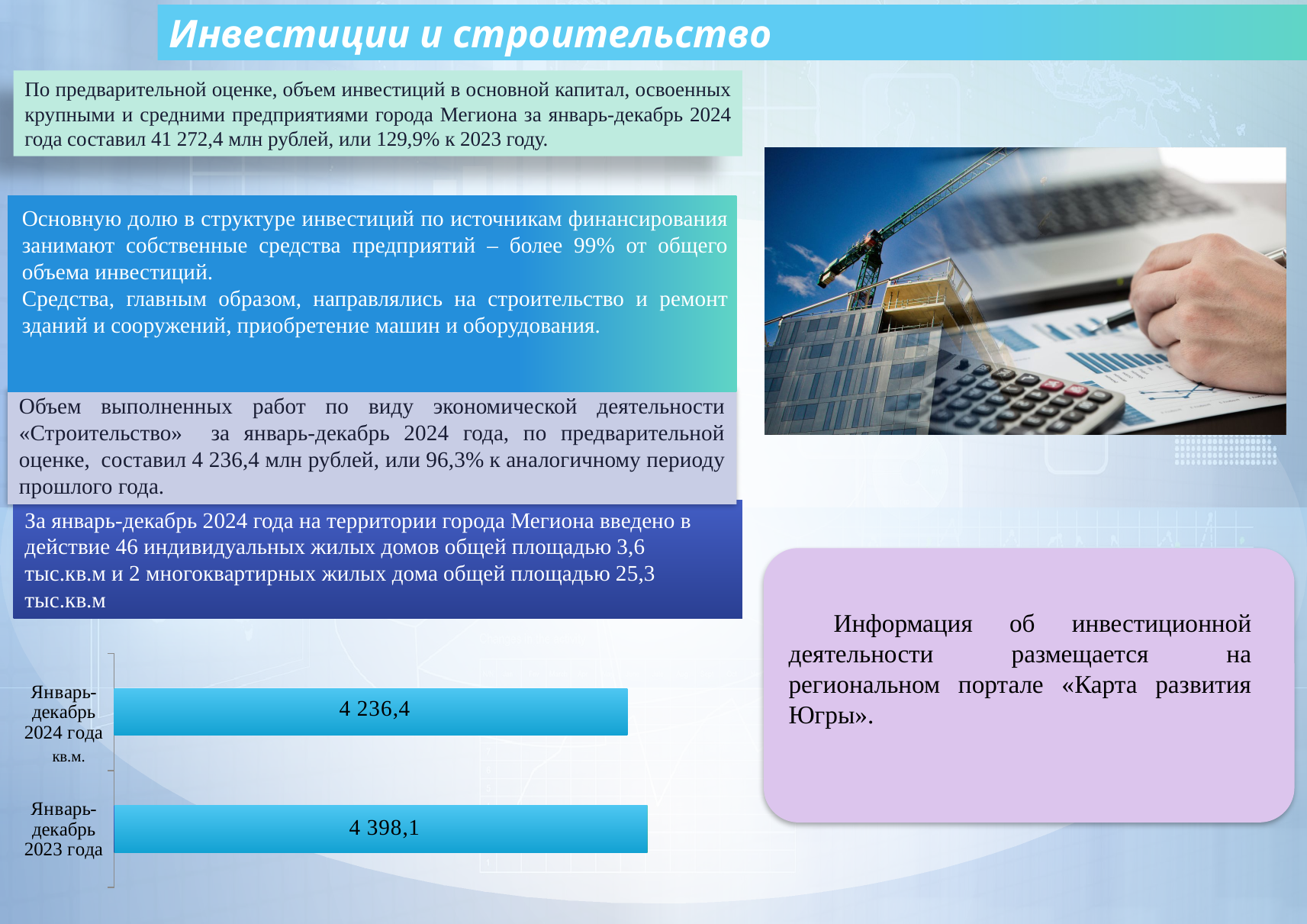
How many bars are plotted in the bar chart? 2 Are the bars in the chart oriented horizontally or vertically? Horizontally What colour are the bars in the chart? Blue Which category has the highest value in the bar chart? Январь-декабрь 2023 года Did the value fall or rise from Январь-декабрь 2023 года to Январь-декабрь 2024 года in the bar chart? Fall Which category has the lowest value in the bar chart? Январь-декабрь 2024 года What kind of chart is shown at the bottom left of the slide? Bar chart What is the value shown for Январь-декабрь 2024 года in the bar chart? 4 236,4 Which is larger in the bar chart: the value for Январь-декабрь 2024 года or for Январь-декабрь 2023 года? Январь-декабрь 2023 года What is the value shown for Январь-декабрь 2023 года in the bar chart? 4 398,1 What is the difference between the values for Январь-декабрь 2023 года and Январь-декабрь 2024 года in the bar chart? 161,7